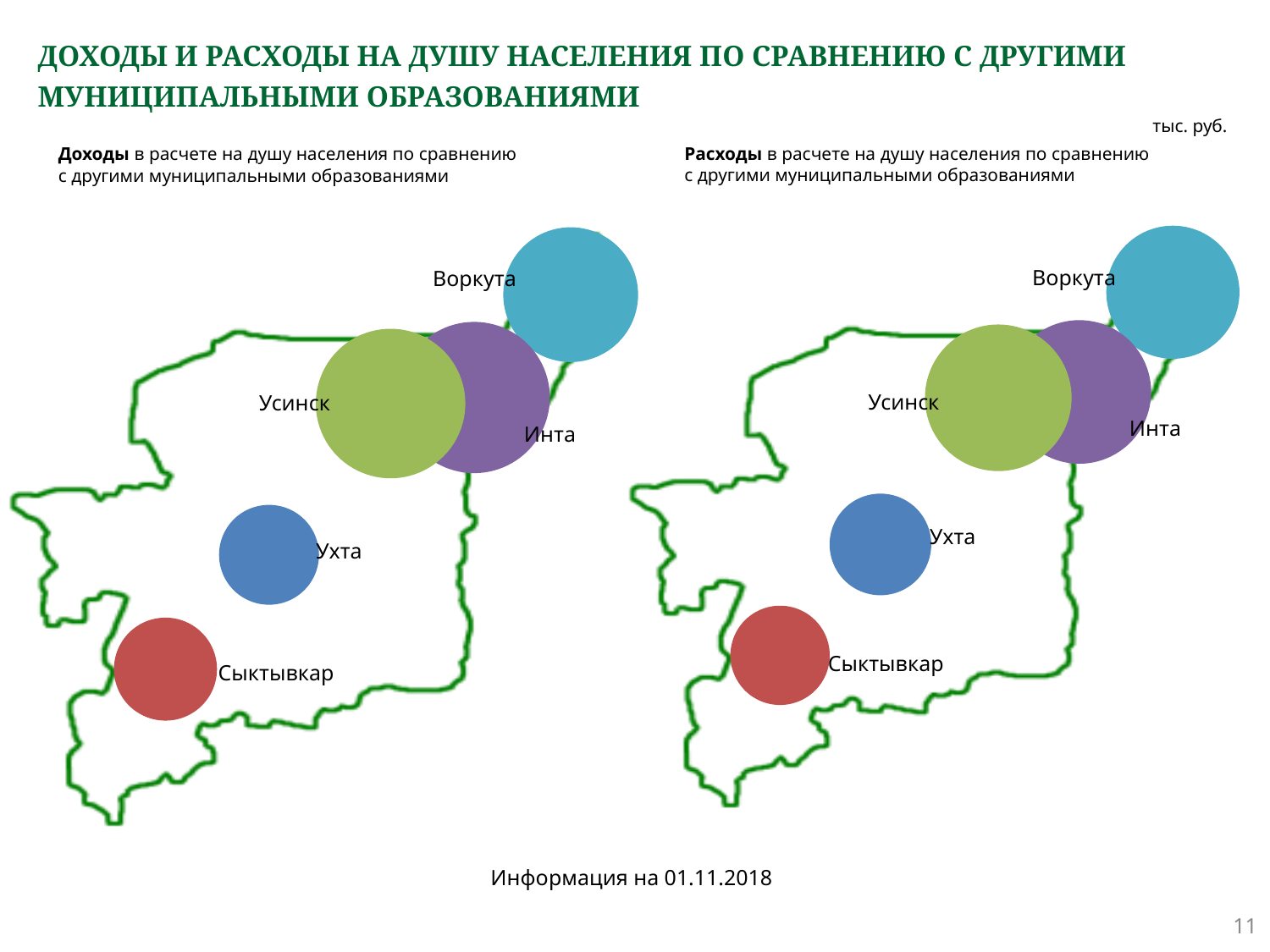
What kind of chart is used on the left (Доходы) chart? Bubble chart On the left (Доходы) chart, which bubble is larger: Воркута or Сыктывкар? Воркута On the right (Расходы) chart, which bubble is larger: Инта or Ухта? Инта How many municipalities (bubbles) are shown on the left (Доходы) chart? 5 On the left (Доходы) chart, which bubble is larger: Усинск or Ухта? Усинск What colour is the Сыктывкар bubble on the left (Доходы) chart? Red How many municipalities (bubbles) are shown on the right (Расходы) chart? 5 What unit of measurement is indicated for the charts on the slide? тыс. руб.